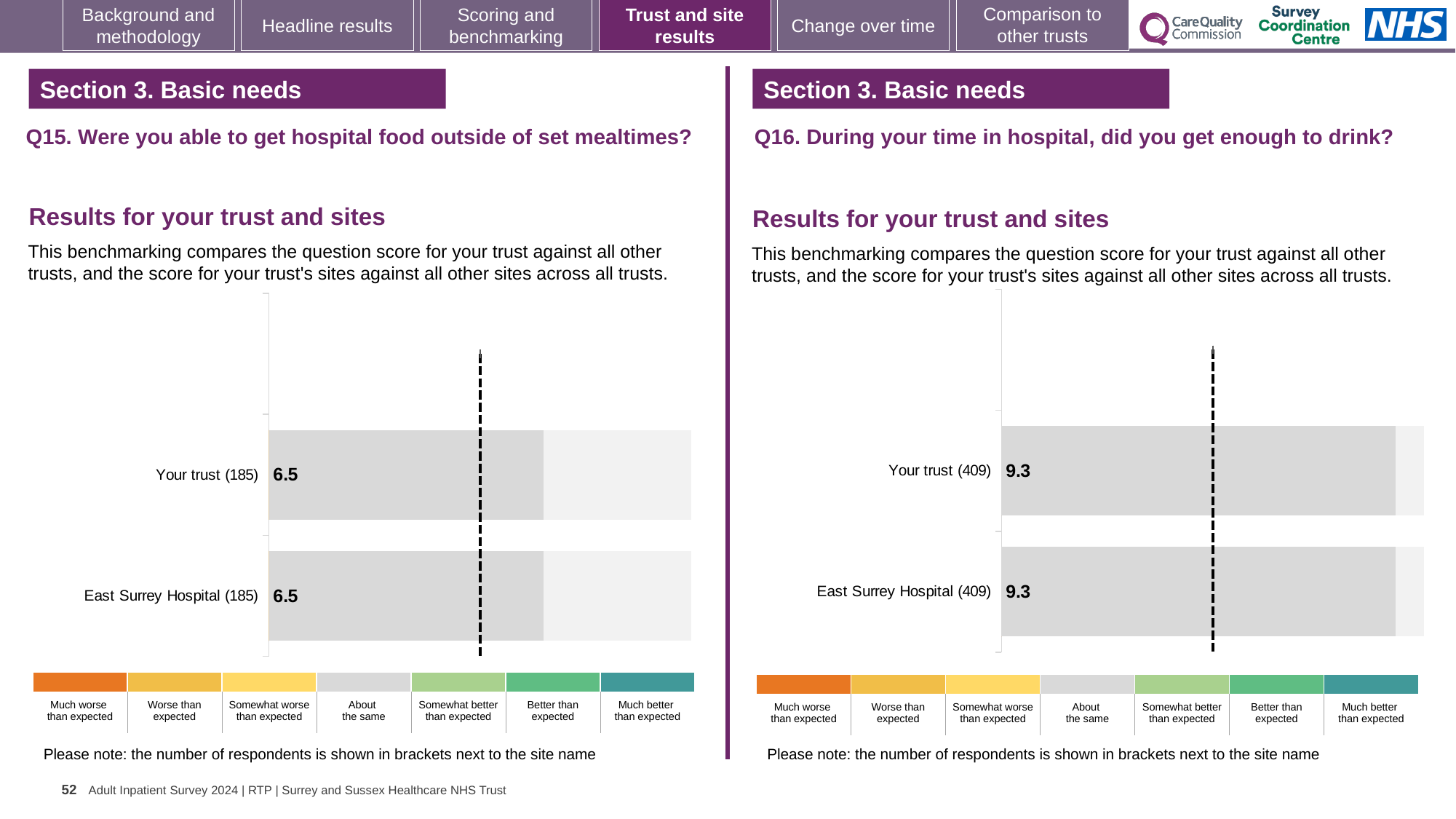
What is the question text shown above the chart on the right? Q16. During your time in hospital, did you get enough to drink? In the Q15 chart on the left, what is the score for Your trust? 6.5 In the Q15 chart on the left, what is the difference between the score for Your trust and the score for East Surrey Hospital? 0.0 In the Q15 chart on the left, how many respondents are shown in brackets for East Surrey Hospital? 185 In the Q15 chart on the left, what is the score for East Surrey Hospital? 6.5 How many categories does the colour key below the Q15 chart on the left list? 7 In the Q16 chart on the right, what is the score for East Surrey Hospital? 9.3 In the Q16 chart on the right, what is the score for Your trust? 9.3 How many bars are plotted in the Q15 chart on the left? 2 In the Q16 chart on the right, what is the difference between the score for Your trust and the score for East Surrey Hospital? 0.0 What kind of chart is the Q16 chart on the right? Bar chart In the Q16 chart on the right, how many respondents are shown in brackets for Your trust? 409